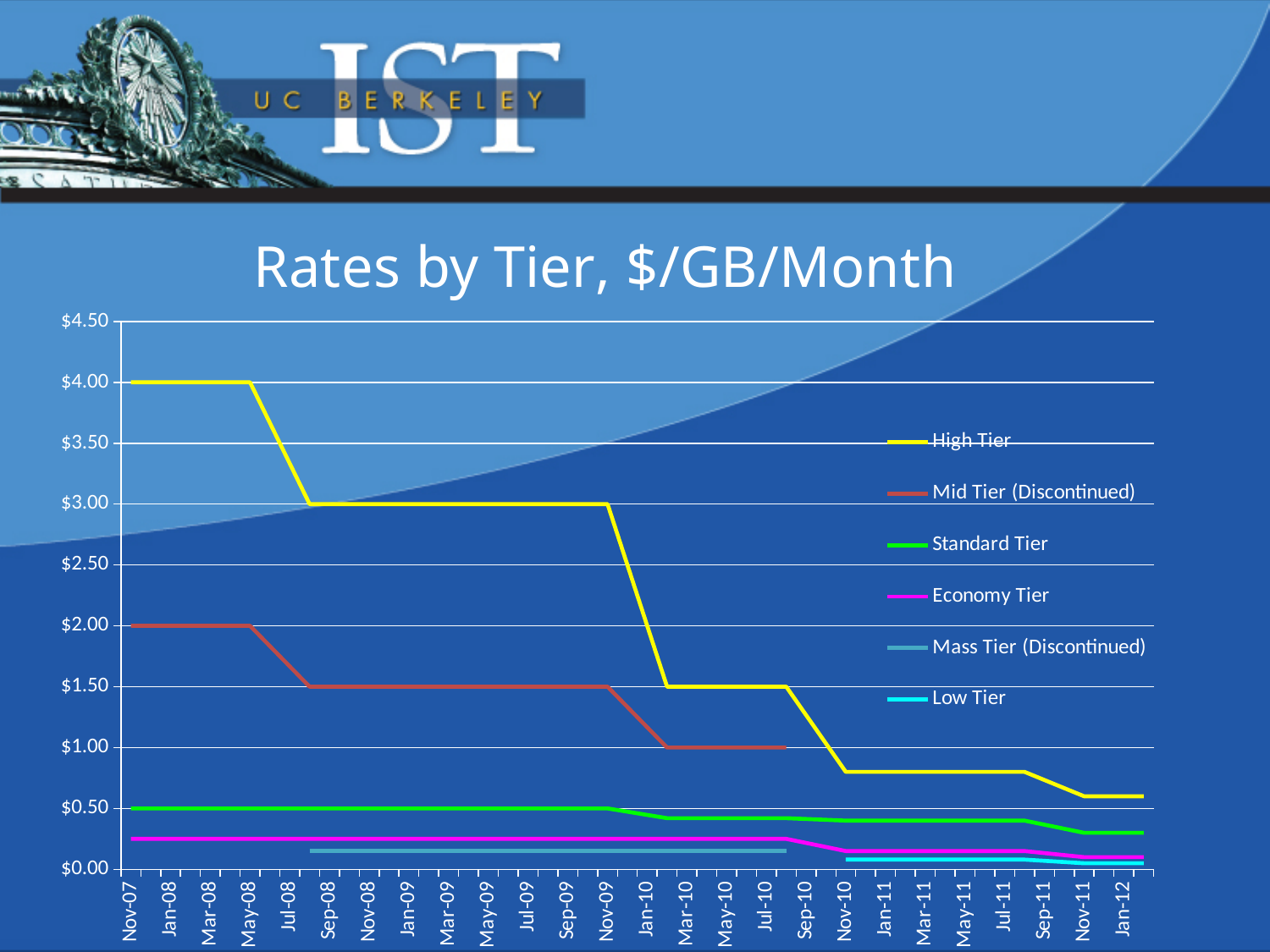
Which series has the highest rate at Nov-07? High Tier What kind of chart is shown on the slide? line chart Does the High Tier rate rise or fall over time along the x axis? fall What is the High Tier rate at Jan-09? $3.00 What is the High Tier rate at Nov-07? $4.00 Is the High Tier rate at Jan-12 greater or less than $1.00? less What is the Mid Tier (Discontinued) rate at Nov-07? $2.00 How many series does the legend list? 6 What is the Mid Tier (Discontinued) rate at Mar-10? $1.00 What is the difference between the High Tier and Mid Tier (Discontinued) rates at Nov-07? $2.00 What is the Standard Tier rate at Nov-07? $0.50 What is the title of the chart? Rates by Tier, $/GB/Month